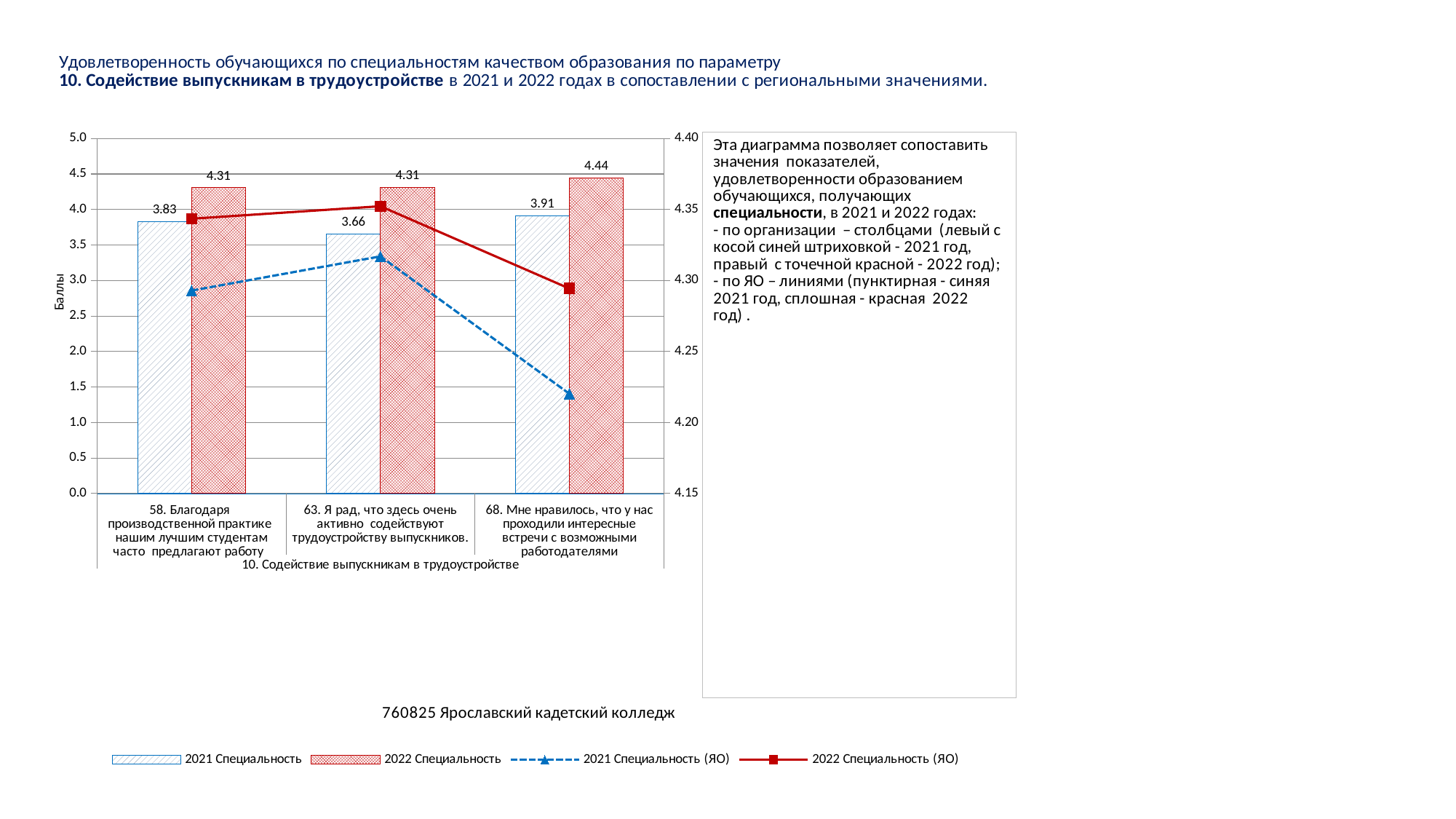
How many items (categories) are shown on the x axis? 3 Which item has the highest 2022 Специальность value? 68. Мне нравилось, что у нас проходили интересные встречи с возможными работодателями How many series does the legend list? 4 What is the label of the left vertical axis? Баллы What is the 2022 Специальность value for item 68 (Мне нравилось, что у нас проходили интересные встречи с возможными работодателями)? 4.44 Which item has the lowest 2021 Специальность value? 63. Я рад, что здесь очень активно содействуют трудоустройству выпускников. Is the 2022 Специальность (ЯО) value for item 58 greater or less than 4.30 on the right axis? greater What is the difference between the 2022 and 2021 Специальность values for item 63? 0.65 Is the 2021 Специальность (ЯО) value for item 68 greater or less than 4.25 on the right axis? less What is the 2022 Специальность value for item 63 (Я рад, что здесь очень активно содействуют трудоустройству выпускников)? 4.31 For item 58, which is larger: the 2021 Специальность bar or the 2022 Специальность bar? 2022 Специальность What is the 2021 Специальность value for item 58 (Благодаря производственной практике нашим лучшим студентам часто предлагают работу)? 3.83